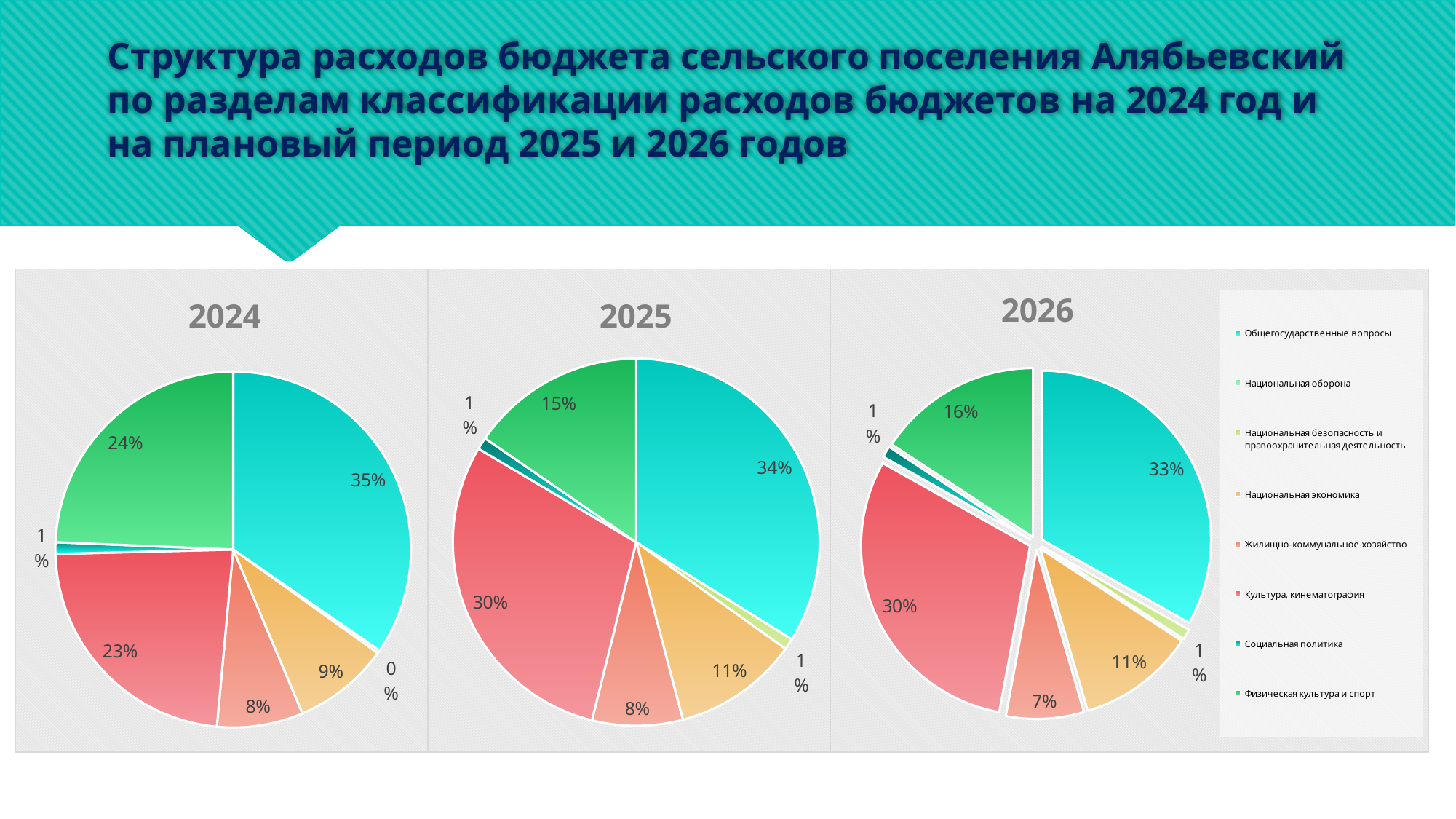
In the 2026 pie chart, which is larger: Физическая культура и спорт or Национальная экономика? Физическая культура и спорт In the 2024 pie chart, what share is Культура, кинематография? 23% How many categories does the legend list? 8 In the 2026 pie chart, what is the difference between the shares of Общегосударственные вопросы and Культура, кинематография? 3% In the 2024 pie chart, what share is Физическая культура и спорт? 24% What type of charts are shown on the slide? Pie charts In the 2025 pie chart, which category has the largest share? Общегосударственные вопросы In the 2026 pie chart, what share is Жилищно-коммунальное хозяйство? 7% How many pie charts are on the slide? 3